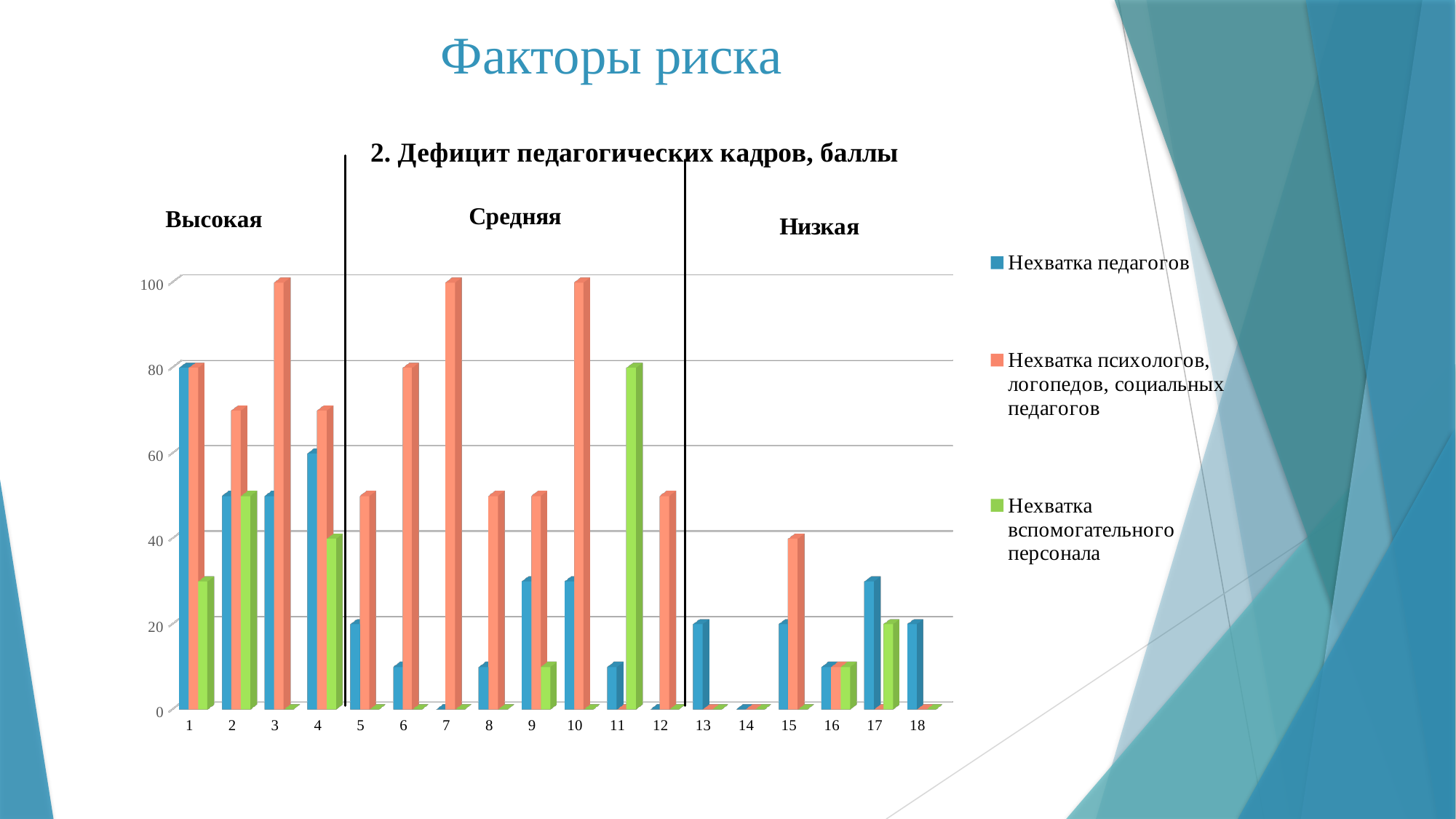
Which is larger for category 15: 'Нехватка педагогов' or 'Нехватка психологов, логопедов, социальных педагогов'? Нехватка психологов, логопедов, социальных педагогов What is the title of the chart? 2. Дефицит педагогических кадров, баллы What is the value of 'Нехватка педагогов' for category 4? 60 What is the value of 'Нехватка педагогов' for category 1? 80 Is the value of 'Нехватка педагогов' for category 9 greater or less than 40? less Is the value of 'Нехватка психологов, логопедов, социальных педагогов' for category 2 greater or less than 60? greater What is the value of 'Нехватка психологов, логопедов, социальных педагогов' for category 3? 100 What is the difference between 'Нехватка психологов, логопедов, социальных педагогов' for category 7 and 'Нехватка педагогов' for category 5? 80 What is the value of 'Нехватка вспомогательного персонала' for category 11? 80 How many series does the legend list? 3 How many categories are shown on the x axis? 18 What type of chart is shown on the slide? bar chart